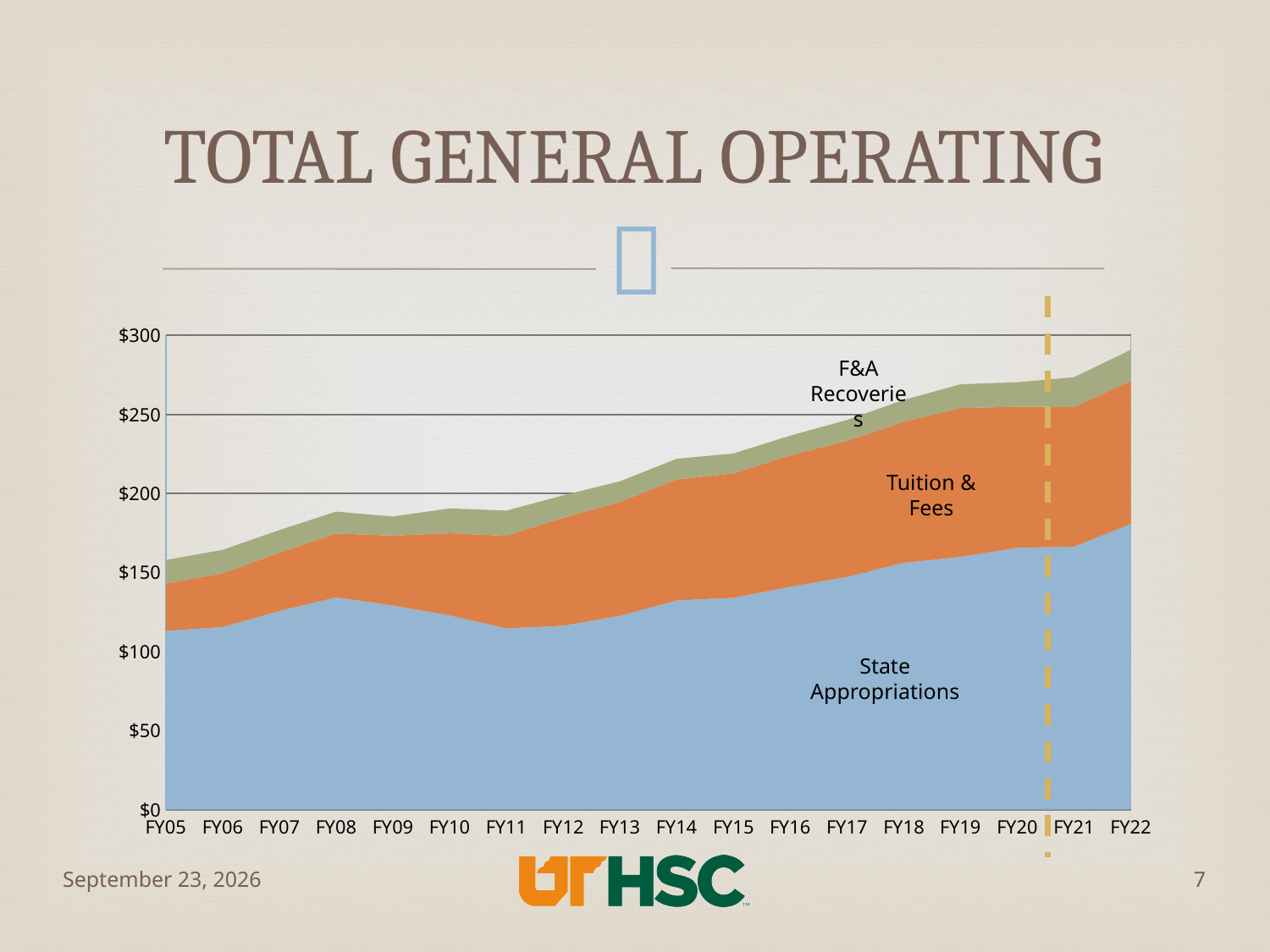
Is the total general operating amount in FY14 greater or less than $200? greater Does the total general operating amount rise or fall from FY05 to FY22 overall? rise Is the total general operating amount in FY22 greater or less than $250? greater Is the value for State Appropriations in FY05 greater or less than $150? less Does the State Appropriations area rise or fall from FY08 to FY11? fall Which series is shown as the bottom (blue) area of the chart? State Appropriations What kind of chart is shown on the slide? Stacked area chart How many fiscal years are shown along the x axis of the chart? 18 How many series (labeled areas) does the chart show? 3 What is the title of the chart on the slide? TOTAL GENERAL OPERATING